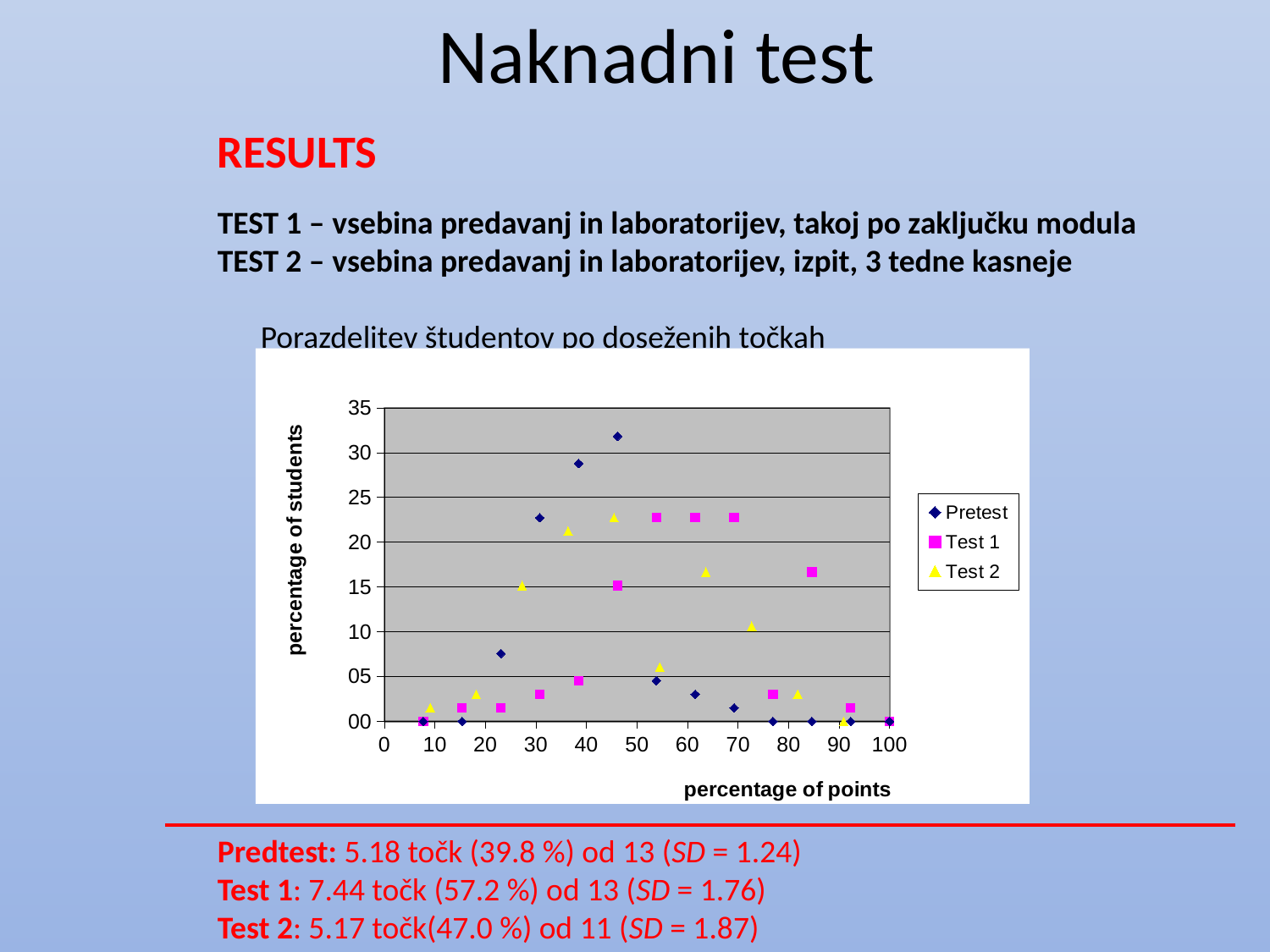
Is the highest Test 1 value on the chart greater or less than 25? less What is the label of the vertical axis of the chart? percentage of students What kind of chart is shown on the slide? scatter chart Is the highest Test 2 value on the chart greater or less than 25? less What are the series names listed in the chart legend? Pretest, Test 1, Test 2 At about 46 percentage of points, which series has the larger value, Pretest or Test 1? Pretest How many series does the chart legend list? 3 Is the Test 1 value at about 85 percentage of points greater or less than 15? greater At about 85 percentage of points, which series has the larger value, Test 1 or Pretest? Test 1 Which series reaches the highest percentage of students on the chart? Pretest